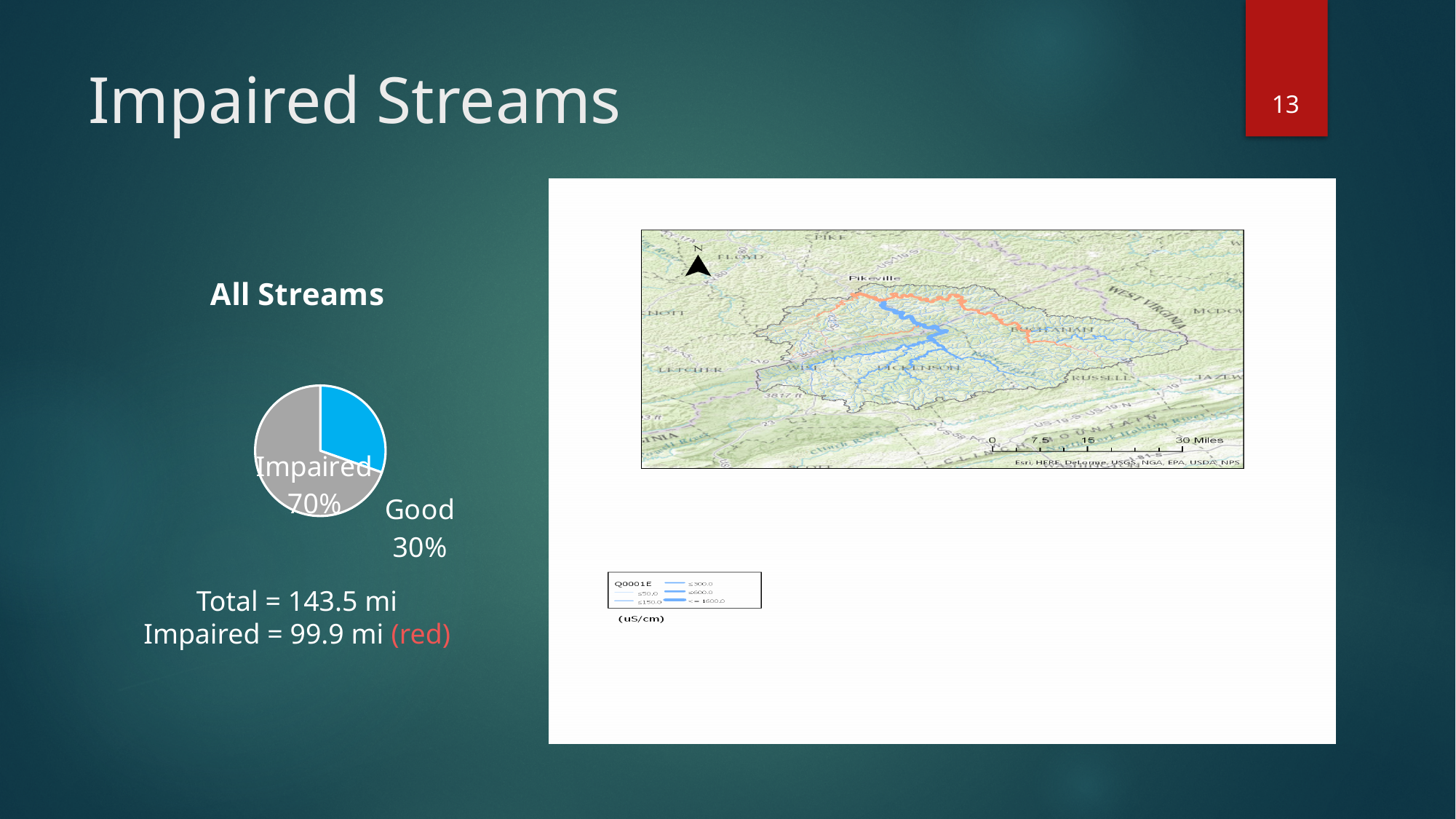
Which slice of the pie chart is the largest? Impaired Is the Impaired share of the pie chart greater or less than 50%? greater What share of the pie chart does the Good slice represent? 30% What is the difference in percentage points between the Impaired and Good slices of the pie chart? 40 What kind of chart is shown under the heading "All Streams"? pie chart What is the title of the pie chart? All Streams What percentage of the pie chart is labelled Good? 30% Which slice of the pie chart is the smallest? Good Which is larger in the pie chart, the Impaired slice or the Good slice? Impaired What percentage of the pie chart is labelled Impaired? 70% What colour is the Good slice of the pie chart? blue How many slices does the pie chart have? 2